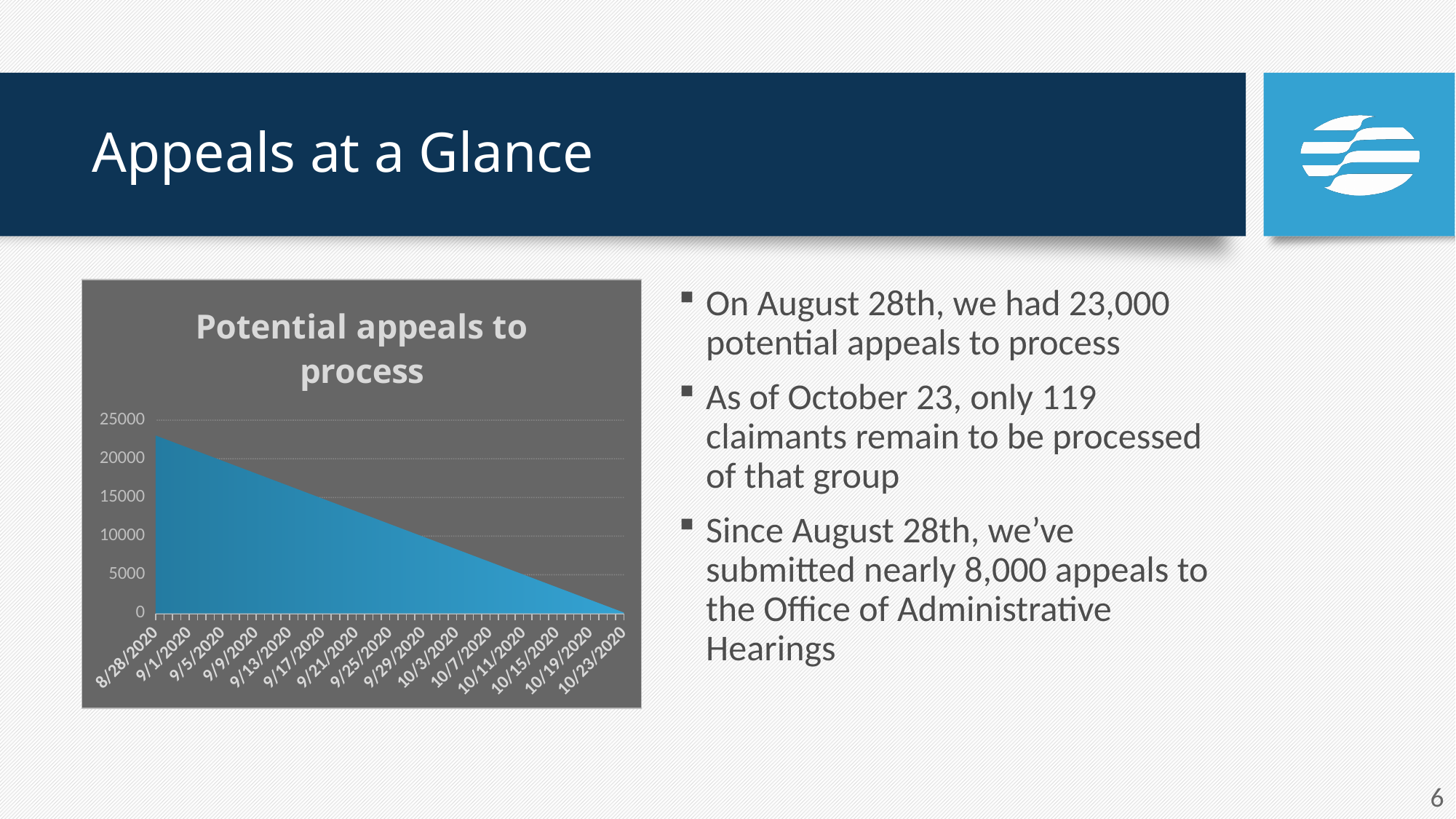
On which date is the value in the chart highest? 8/28/2020 On which date is the value in the chart lowest? 10/23/2020 What is the title of the chart? Potential appeals to process Is the value for 10/23/2020 greater or less than 5000? less Is the value for 8/28/2020 greater or less than 20000? greater What kind of chart is shown on the slide? Area chart What is the highest tick value shown on the chart's vertical axis? 25000 Do the values in the chart rise or fall from 8/28/2020 to 10/23/2020? Fall